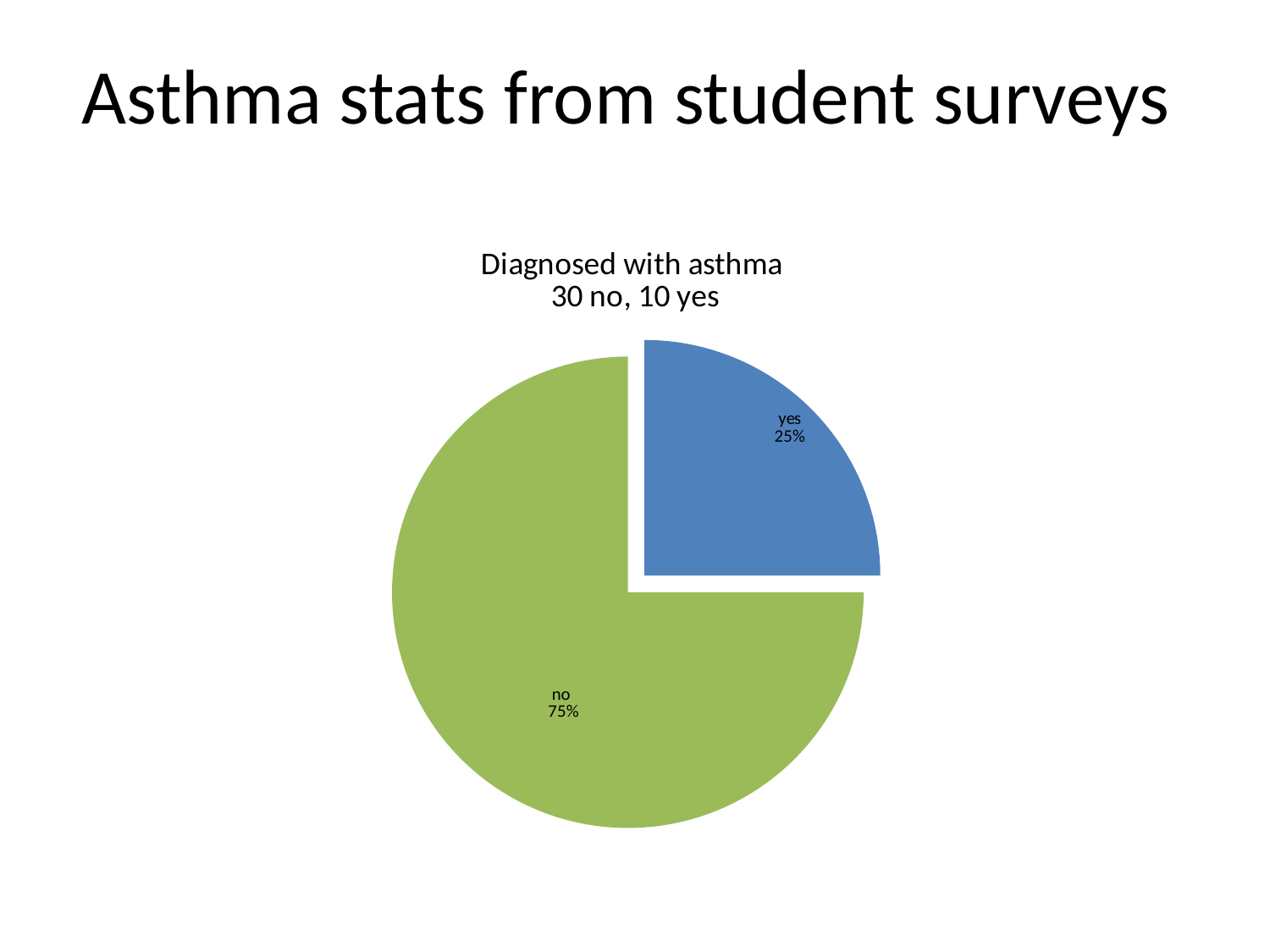
How many slices does the pie chart have? 2 What is the title of the pie chart? Diagnosed with asthma 30 no, 10 yes What percentage of the pie is the "yes" slice? 25% According to the chart title, how many students answered "no"? 30 What kind of chart is shown on the slide? pie chart Which slice of the pie is the largest? no Which slice of the pie is the smallest? yes Which is larger, the "yes" slice or the "no" slice? no What percentage of the pie is the "no" slice? 75% According to the chart title, how many students answered "yes"? 10 What is the difference in percentage points between the "no" slice and the "yes" slice? 50 What colour is the "yes" slice of the pie? blue